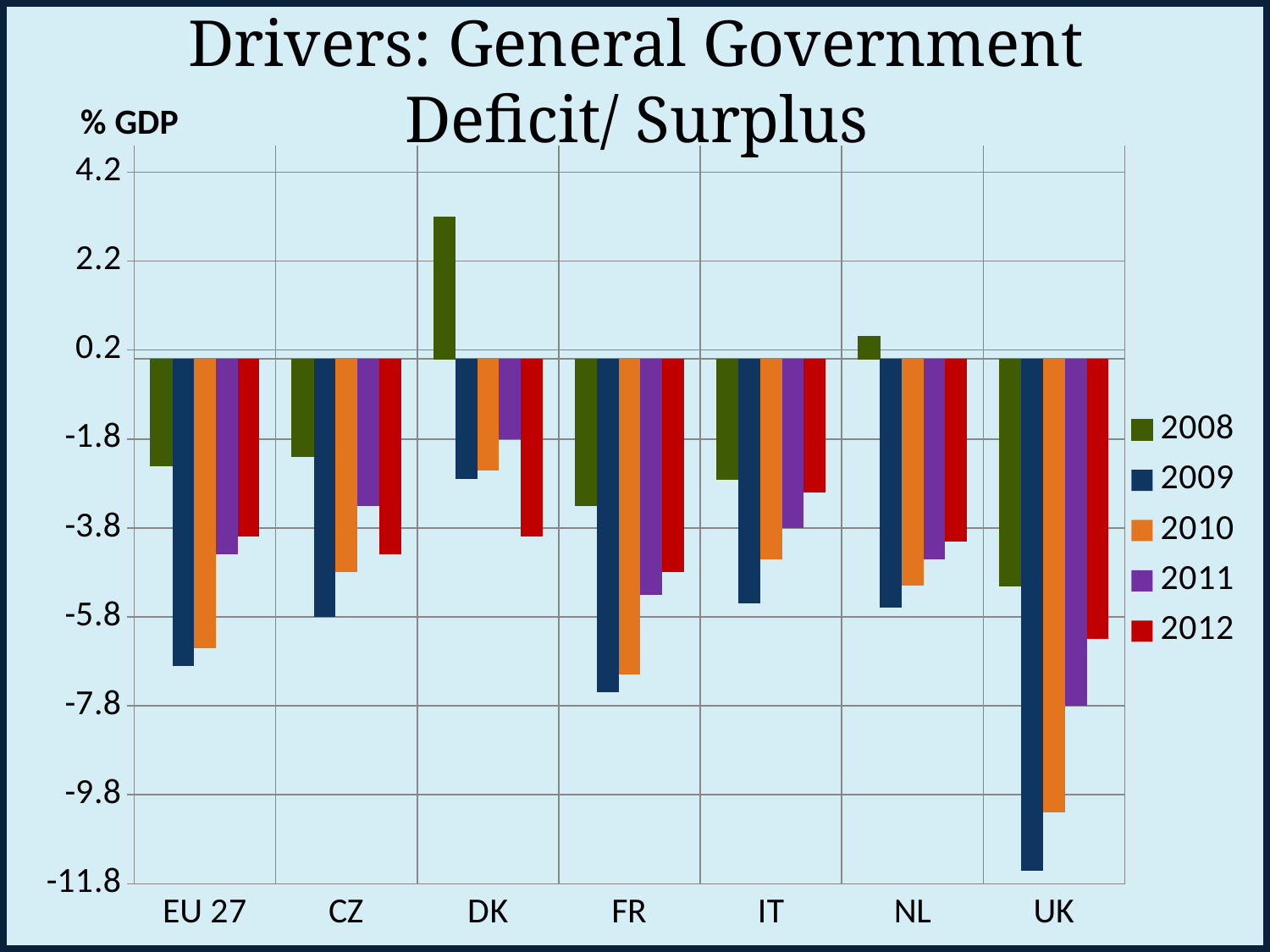
Which country has the highest value for 2008? DK How many countries/regions are shown on the x axis? 7 For UK, do the values rise or fall from 2009 to 2012? rise What unit is shown on the y axis label? % GDP Is the 2009 value for FR greater or less than -5.8? less Is the 2009 value for UK greater or less than -9.8? less How many series does the legend list? 5 Is the 2012 value for IT greater or less than -3.8? greater Which country has the lowest value for 2009? UK What kind of chart is shown on the slide? bar chart Which is lower, the 2010 value for UK or the 2010 value for FR? UK